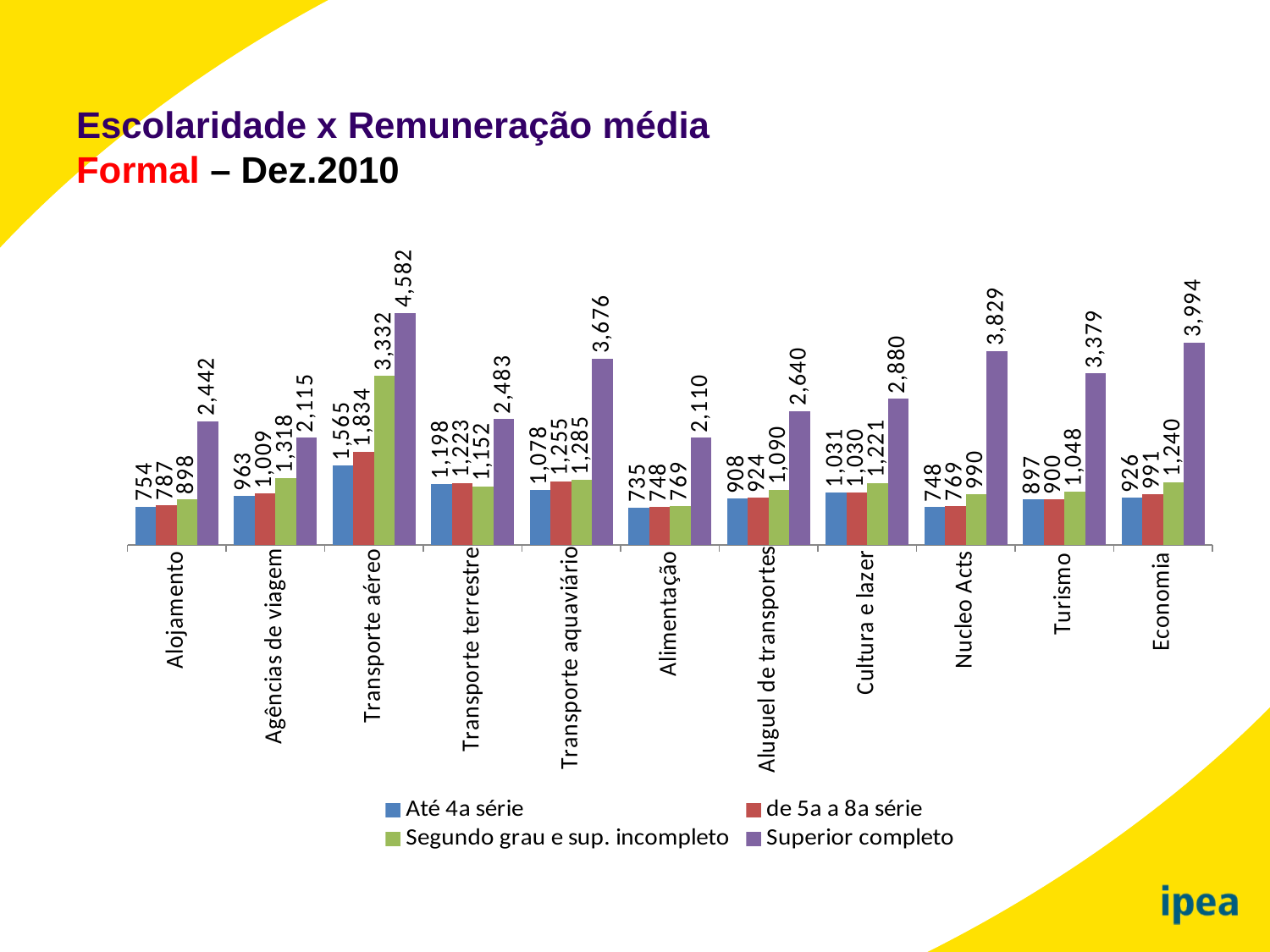
How many series does the legend list? 4 Which category has the highest value for Superior completo? Transporte aéreo What is the value for de 5a a 8a série in Nucleo Acts? 769 What is the value for Até 4a série in Alimentação? 735 What is the difference between the Superior completo value and the Até 4a série value in Turismo? 2,482 How many categories are shown on the x axis? 11 What is the value for Segundo grau e sup. incompleto in Economia? 1,240 What is the value for Superior completo in Transporte aéreo? 4,582 Which series is shown in purple in the legend? Superior completo Which is larger: the Superior completo value for Nucleo Acts or for Economia? Economia Which category has the lowest value for Até 4a série? Alimentação What kind of chart is shown on the slide? Bar chart